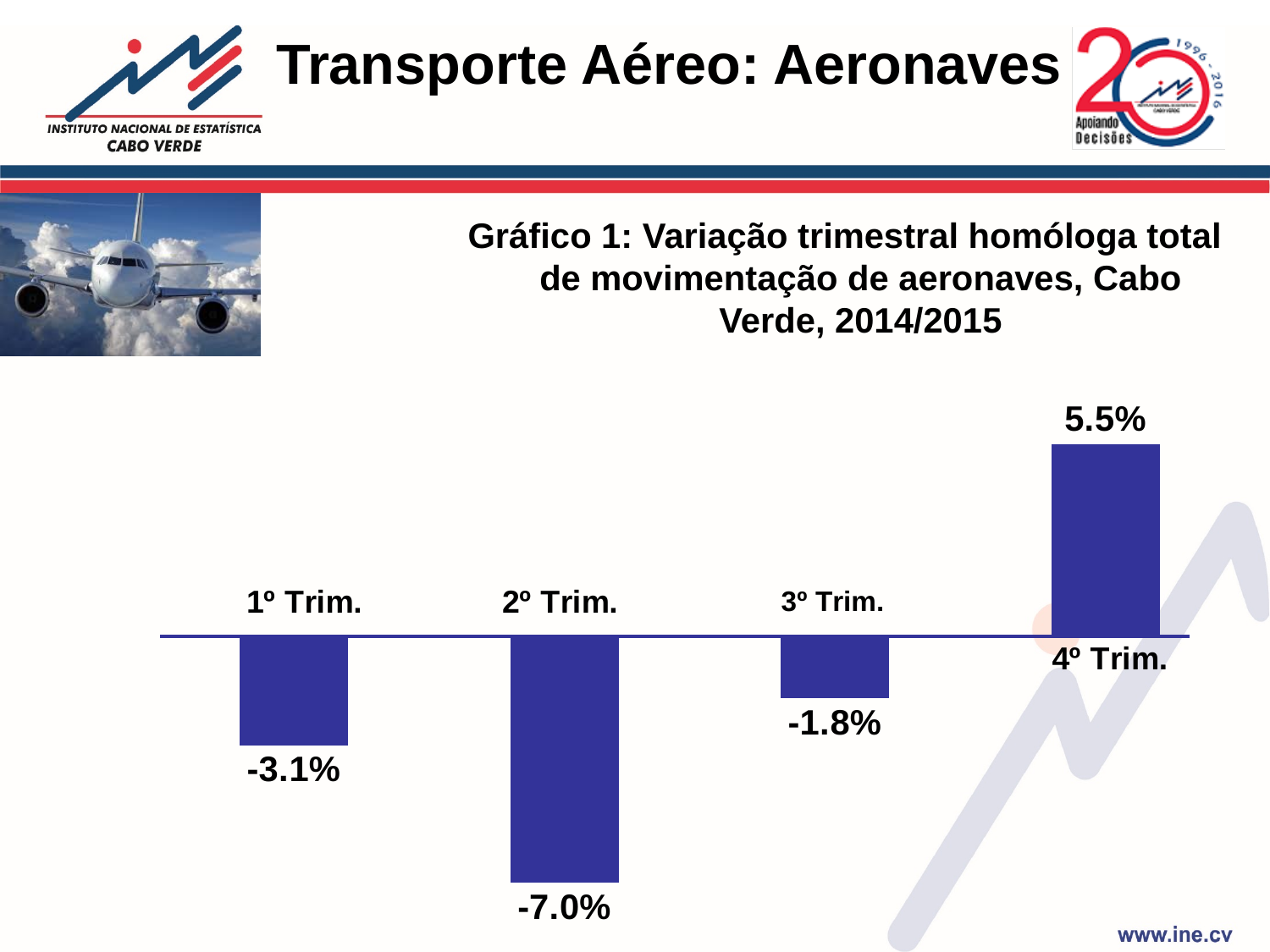
How many quarters have a negative value? 3 What is the difference between the values for 4º Trim. and 2º Trim.? 12.5 percentage points What kind of chart is shown on the slide? Bar chart Which quarter has the lowest value? 2º Trim. How many quarters are shown in the chart? 4 What is the value for 3º Trim.? -1.8% What is the title of the chart? Gráfico 1: Variação trimestral homóloga total de movimentação de aeronaves, Cabo Verde, 2014/2015 Which is larger, the value for 1º Trim. or the value for 3º Trim.? 3º Trim. What is the value for 4º Trim.? 5.5% Which quarter has the highest value? 4º Trim. What is the value for 1º Trim.? -3.1% What is the value for 2º Trim.? -7.0%